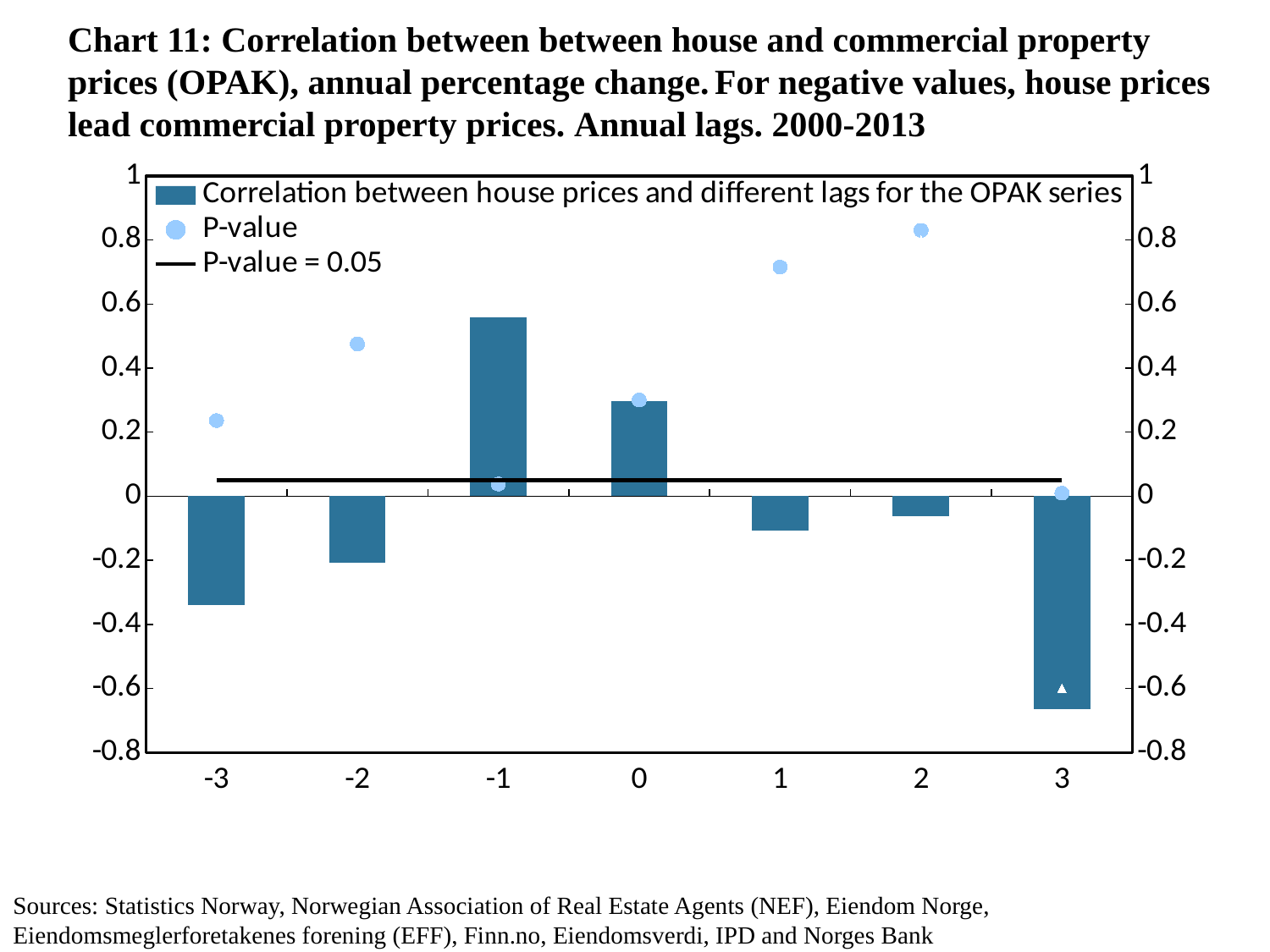
At which lag is the correlation bar lowest? 3 Which has the larger correlation bar, lag 0 or lag -1? -1 What does the legend call the horizontal black line? P-value = 0.05 At which lag is the P-value highest? 2 At which lag is the correlation bar highest? -1 What kind of chart is shown on the slide? combination bar and line chart Is the correlation value at lag -1 greater or less than 0.4? greater Is the correlation value at lag -3 greater or less than -0.2? less How many lag categories are shown on the x axis? 7 Is the P-value at lag 2 greater or less than 0.6? greater How many series does the legend list? 3